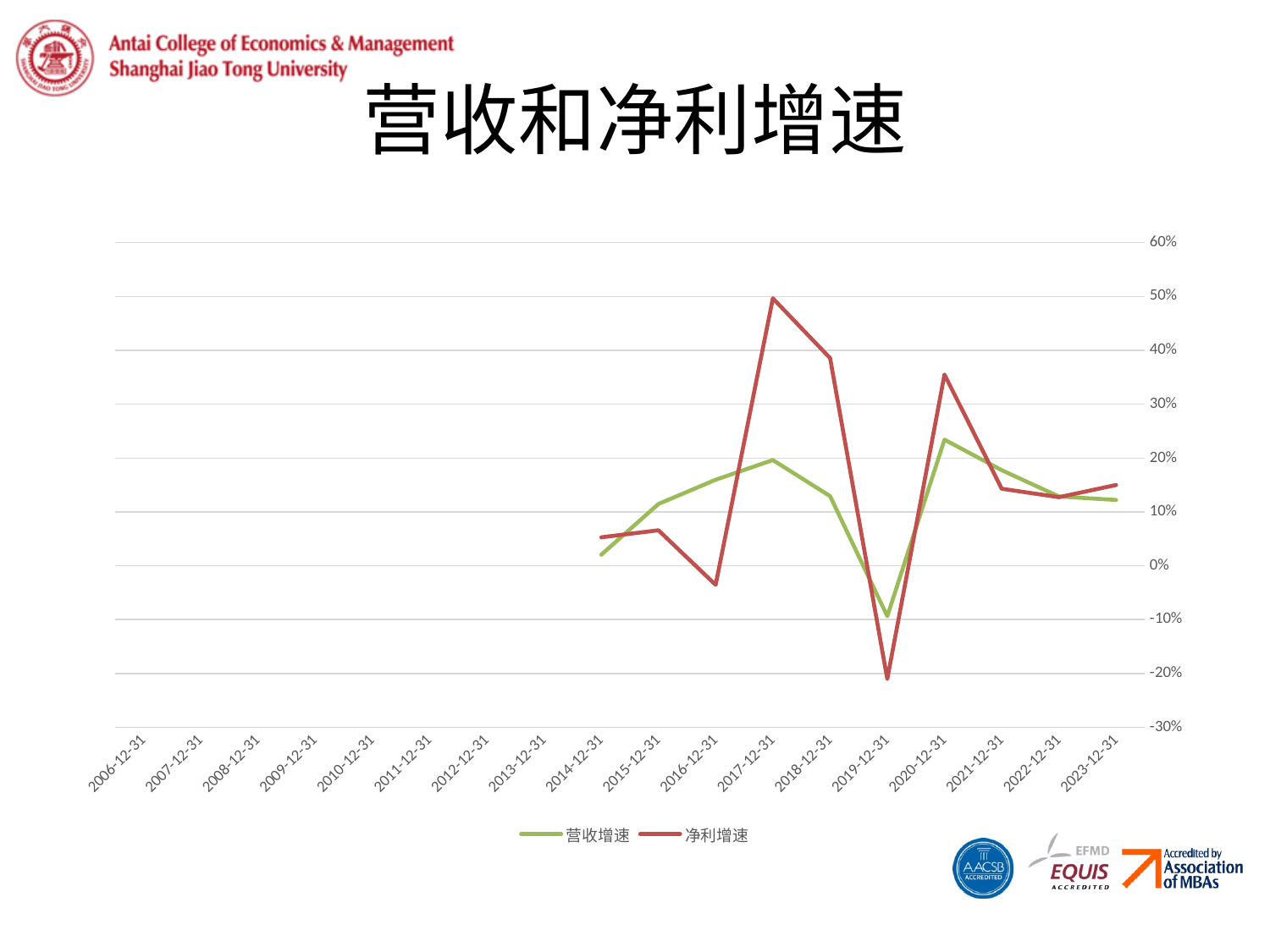
How many series does the legend list? 2 Is the value of 净利增速 at 2017-12-31 greater or less than 40%? greater What kind of chart is shown on the slide? line chart Does 营收增速 rise or fall from 2014-12-31 to 2017-12-31? rise At which date does 营收增速 reach its lowest value? 2019-12-31 At which date does 净利增速 reach its highest value? 2017-12-31 At which date does 营收增速 reach its highest value? 2020-12-31 At which date does 净利增速 reach its lowest value? 2019-12-31 At 2016-12-31, which series has the larger value, 营收增速 or 净利增速? 营收增速 What is the title of the chart? 营收和净利增速 Is the value of 净利增速 at 2019-12-31 greater or less than -10%? less What are the two series named in the legend? 营收增速 and 净利增速